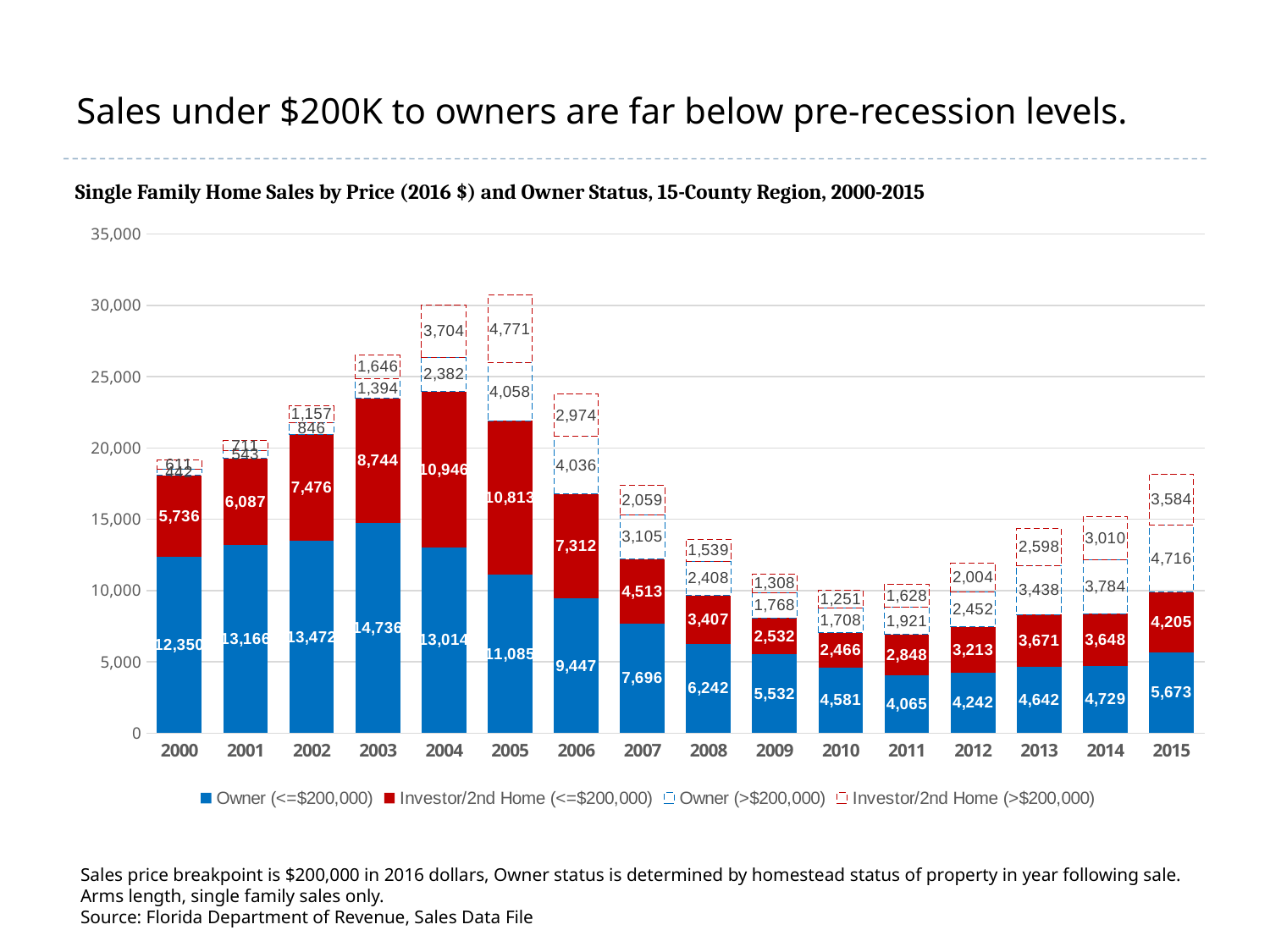
What is the value for Investor/2nd Home (>$200,000) in 2015? 3,584 In which year is the Owner (<=$200,000) value highest? 2003 Which is larger in 2005: Owner (<=$200,000) or Investor/2nd Home (<=$200,000)? Owner (<=$200,000) What kind of chart is shown on the slide? Stacked bar chart What is the total of the stacked bar for 2000? 19,139 In which year is the Owner (<=$200,000) value lowest? 2011 How many series does the legend list? 4 What is the value for Owner (<=$200,000) in 2003? 14,736 What is the value for Investor/2nd Home (<=$200,000) in 2004? 10,946 What is the difference between the Owner (<=$200,000) value in 2003 and in 2015? 9,063 How many years are shown on the x axis? 16 In which year is the Investor/2nd Home (>$200,000) value highest? 2005